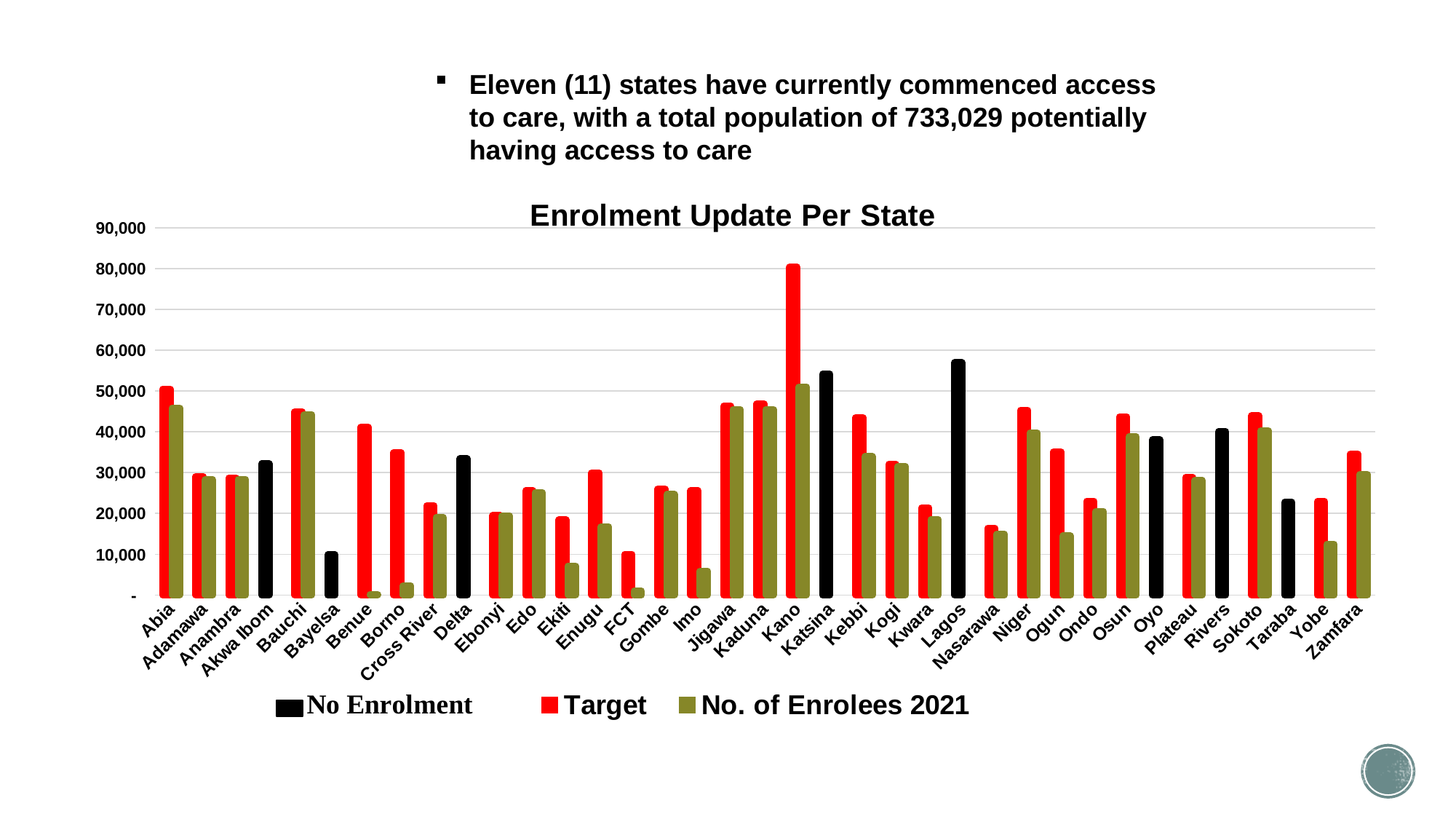
Which state has the highest Target value in 'Enrolment Update Per State'? Kano Is the Target value for Kebbi greater or less than 40,000? greater Is the Target value for Kano greater or less than 70,000? greater Which is larger: the Target value for Abia or the Target value for Adamawa? Abia Which state has the highest No Enrolment value in 'Enrolment Update Per State'? Lagos Is the No Enrolment value for Lagos greater or less than 50,000? greater How many states are shown on the x axis of 'Enrolment Update Per State'? 37 How many series does the legend of 'Enrolment Update Per State' list? 3 What type of chart is 'Enrolment Update Per State'? bar chart Which state has the highest No. of Enrolees 2021 value in 'Enrolment Update Per State'? Kano What colour are the No Enrolment bars in 'Enrolment Update Per State'? black